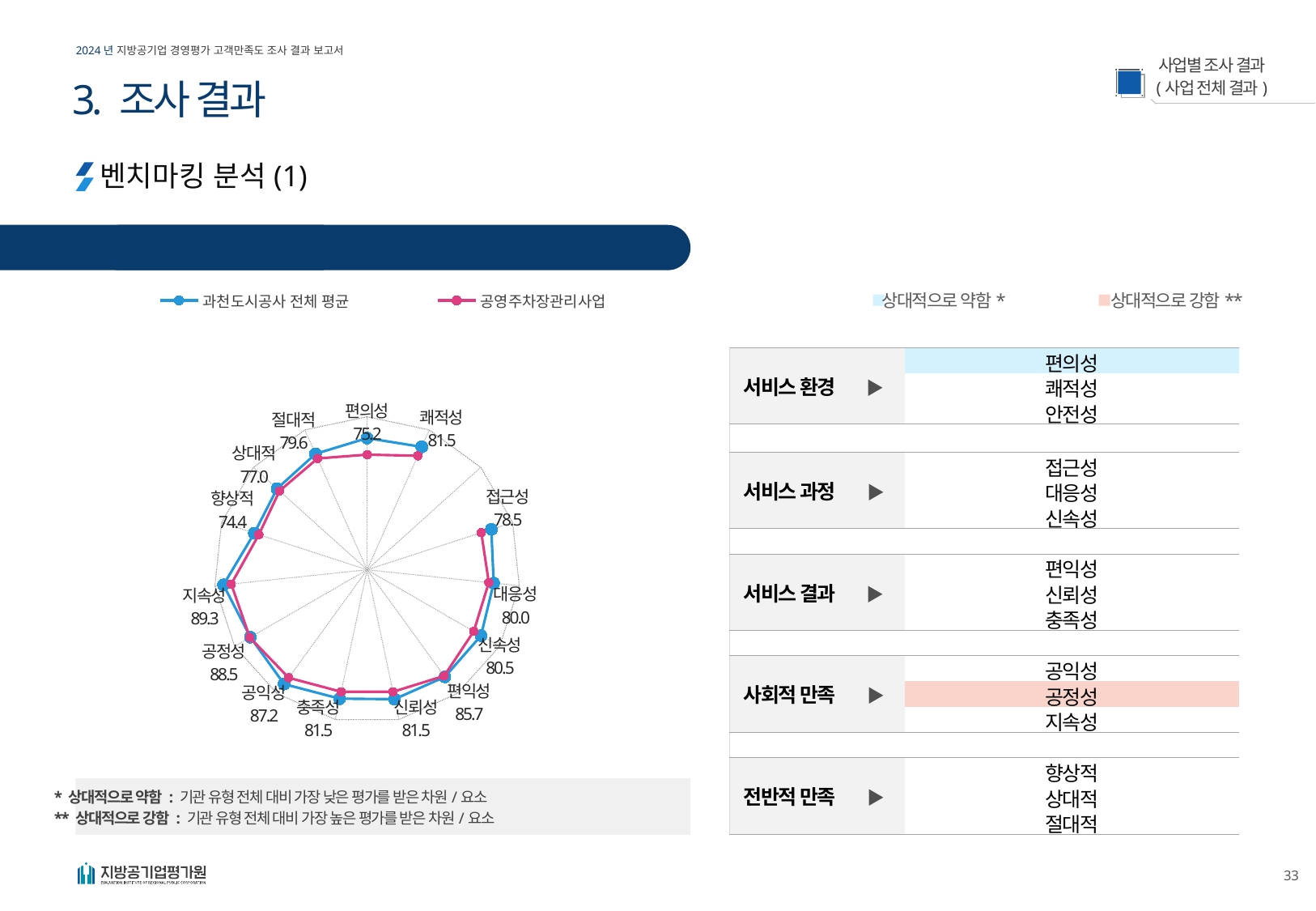
Which category has the lowest labeled value on the radar chart? 향상적 What data label is shown for 편익성 on the radar chart? 85.7 Which has the larger labeled value, 공정성 or 공익성? 공정성 Which category has the highest labeled value on the radar chart? 지속성 How many series does the chart legend list? 2 What data label is shown for 편의성 on the radar chart? 75.2 What data label is shown for 지속성 on the radar chart? 89.3 What data label is shown for 대응성 on the radar chart? 80.0 What are the two legend entries of the radar chart? 과천도시공사 전체 평균, 공영주차장관리사업 What is the difference between the labeled values for 지속성 and 향상적? 14.9 What kind of chart is shown on the slide? Radar chart